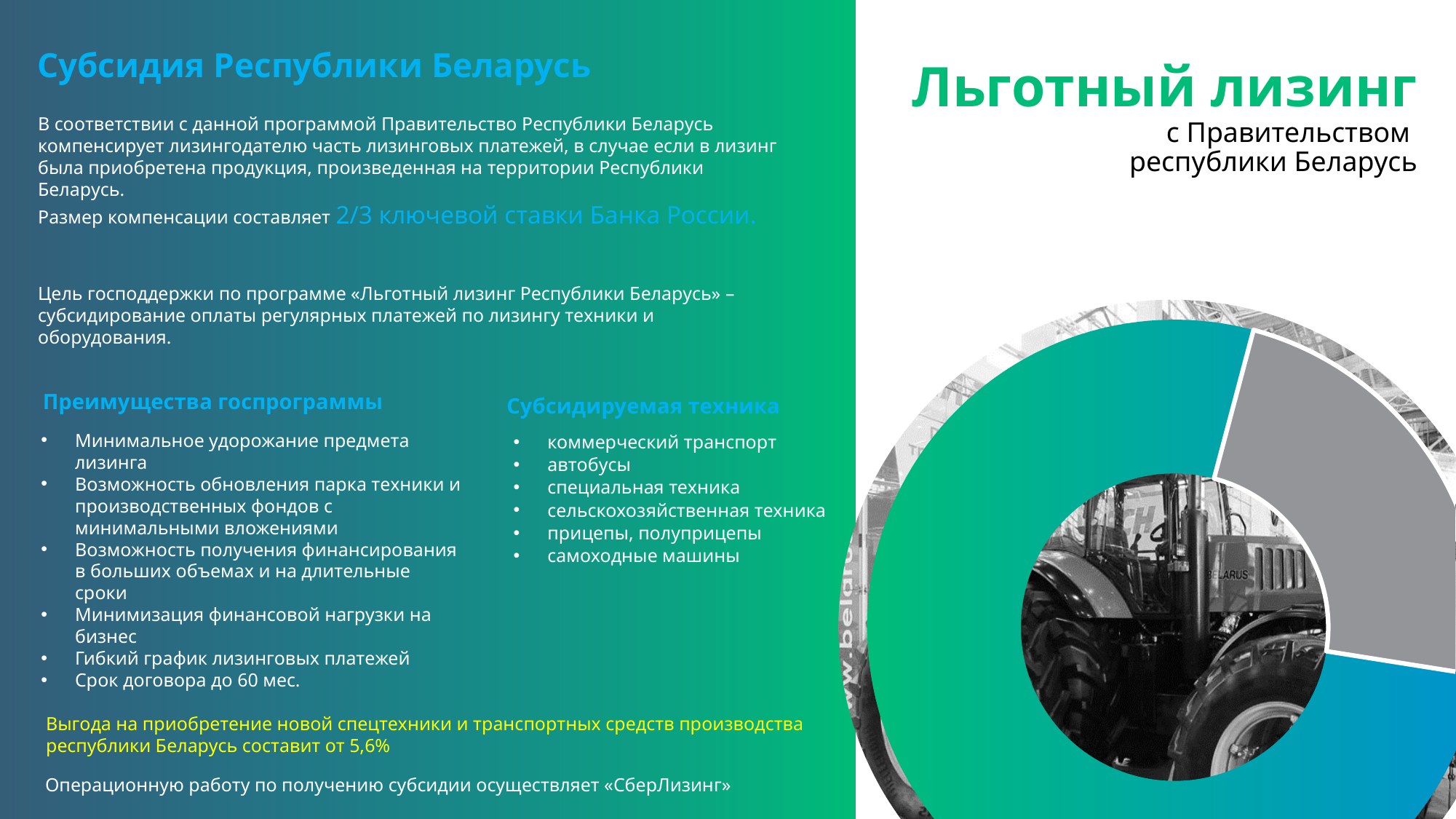
In the doughnut chart on the right side of the slide, which slice is larger: the green one or the gray one? Green In the doughnut chart on the right side of the slide, which slice is larger: the gray one or the blue one? Gray What is shown in the centre of the doughnut chart on the right side of the slide? A photo of a tractor Does the doughnut chart on the right side of the slide display any data labels or a legend? No How many slices does the doughnut chart on the right side of the slide have? 3 Which colour slice is the smallest in the doughnut chart on the right side of the slide? Blue Which colour slice is the largest in the doughnut chart on the right side of the slide? Green What kind of chart is shown on the right side of the slide? Doughnut (pie) chart